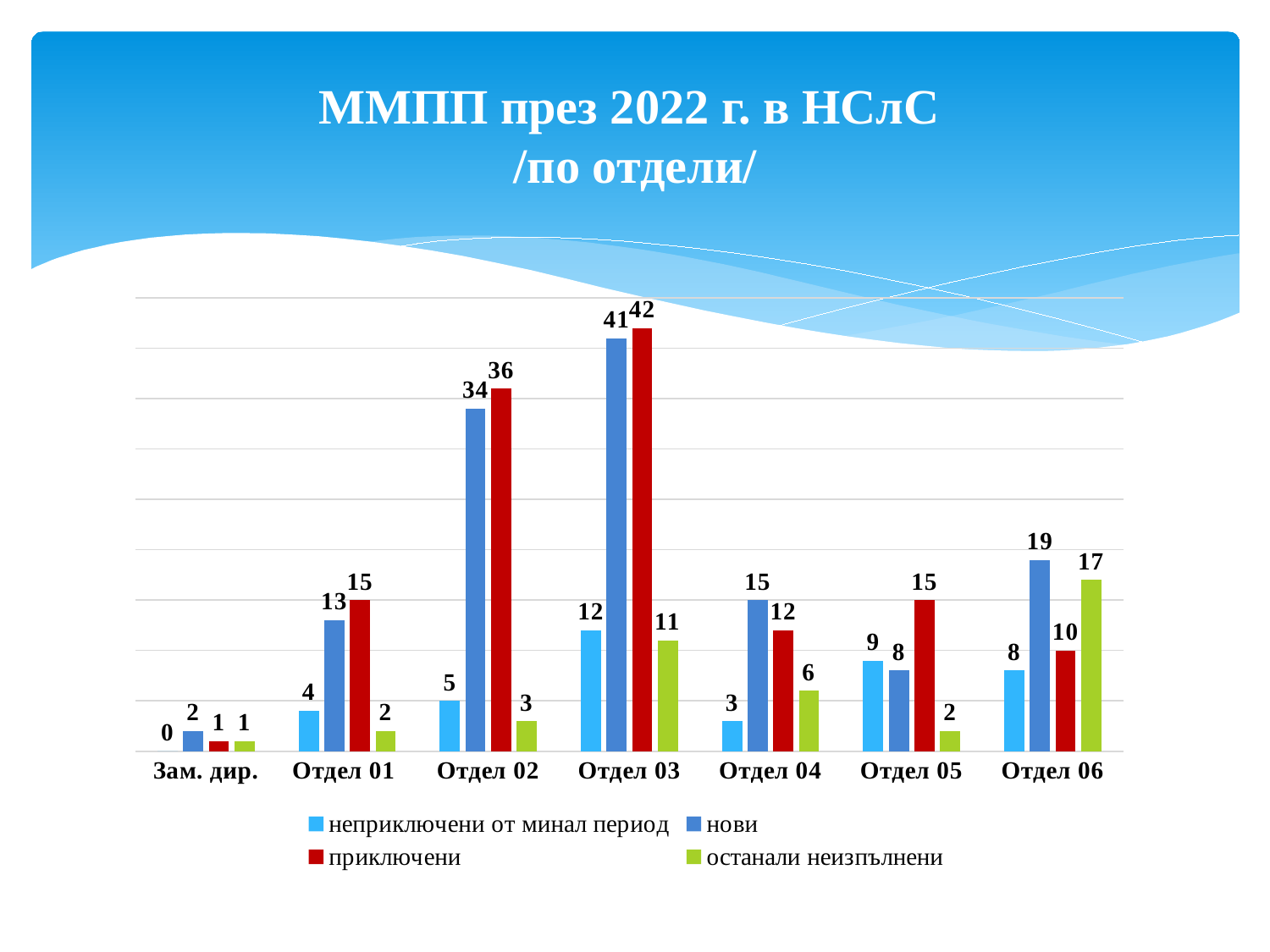
What is the value of "останали неизпълнени" for Отдел 06? 17 Which category has the highest value for "нови"? Отдел 03 What type of chart is shown on the slide? bar chart What is the difference between "приключени" and "нови" for Отдел 02? 2 What is the value of "нови" for Отдел 02? 34 Which category has the lowest value for "приключени"? Зам. дир. Which is larger for Отдел 04: "нови" or "приключени"? нови What is the value of "неприключени от минал период" for Отдел 05? 9 How many series does the legend list? 4 What is the value of "приключени" for Отдел 03? 42 What is the title of the chart? ММПП през 2022 г. в НСлС /по отдели/ How many categories are shown on the x axis of the chart? 7